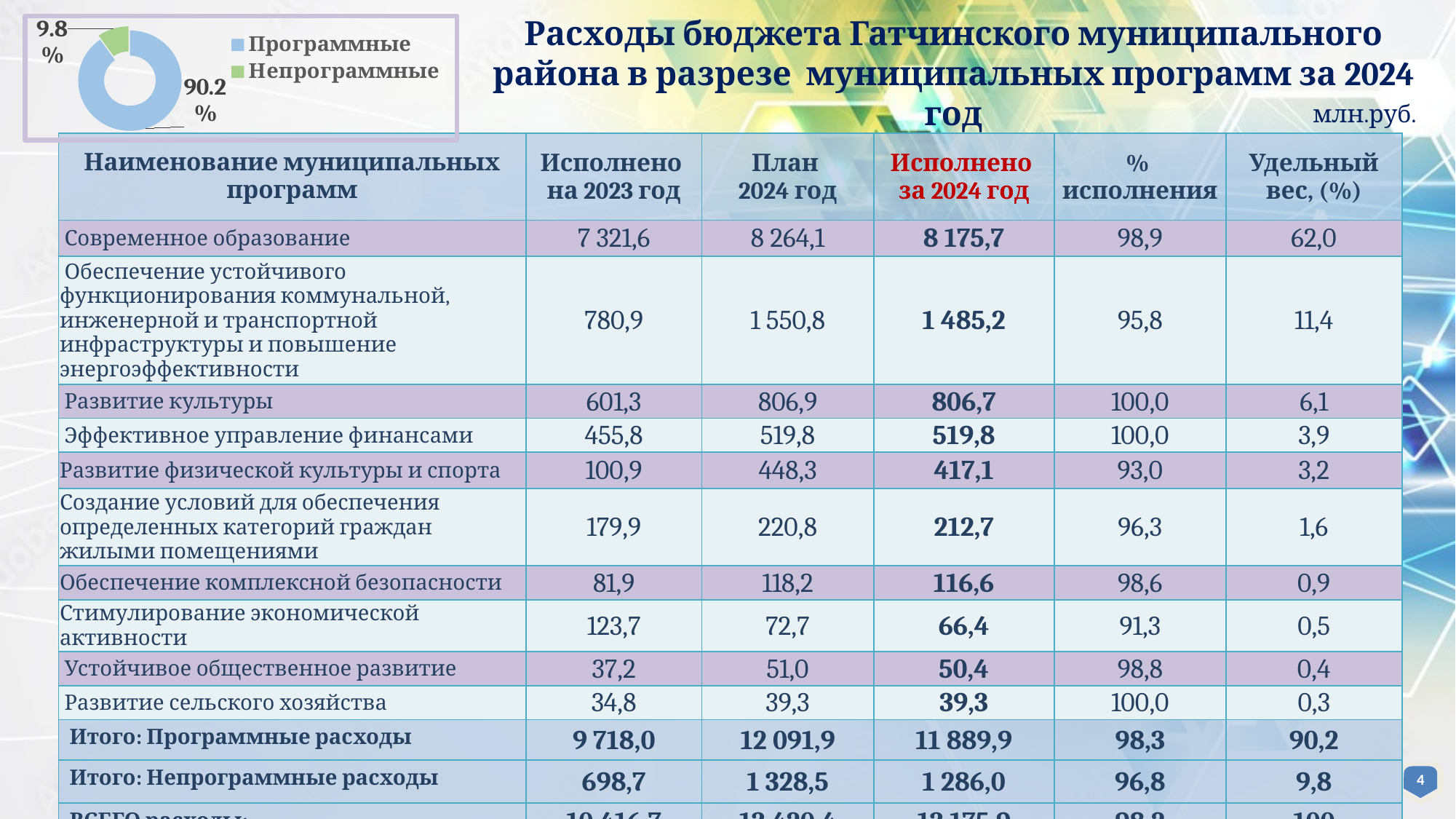
What colour is the Программные slice in the pie chart? Blue How many entries does the legend of the pie chart list? 2 What colour is the Непрограммные slice in the pie chart? Green What share of the pie chart does the Программные slice represent? 90.2% How many slices does the pie chart have? 2 By how many percentage points does the Программные slice exceed the Непрограммные slice in the pie chart? 80.4 What share of the pie chart does the Непрограммные slice represent? 9.8% What type of chart is shown in the top-left corner of the slide? Pie (doughnut) chart Which slice of the pie chart is the smallest? Непрограммные What is the combined share of the two slices in the pie chart? 100% Which slice of the pie chart is the largest? Программные In the pie chart, which is larger: Программные or Непрограммные? Программные